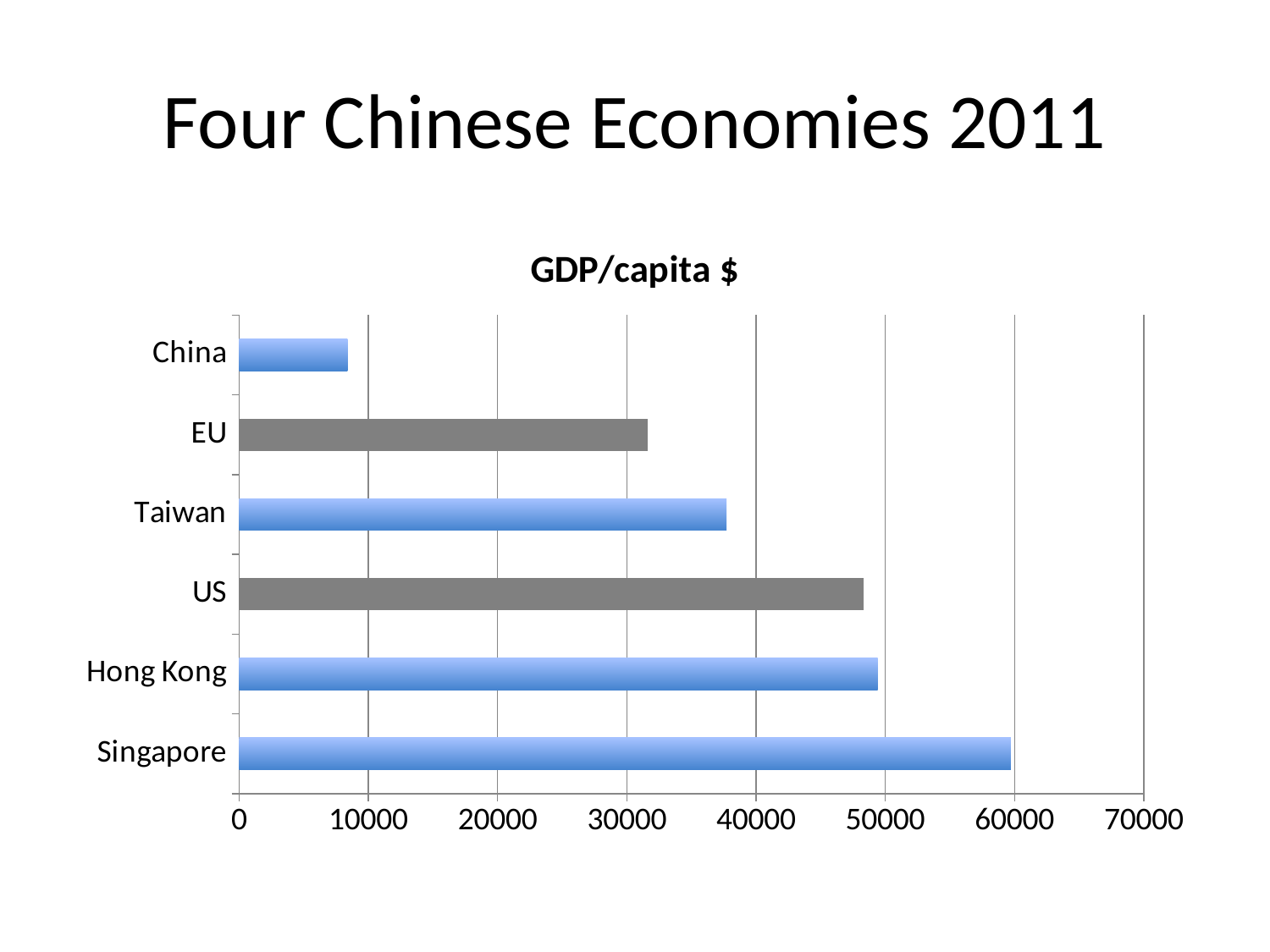
Which has a larger GDP/capita, Taiwan or EU? Taiwan What kind of chart is shown on the slide? bar chart Is the value for EU greater or less than 30000? greater What is the title of the chart? GDP/capita $ Is the value for Taiwan greater or less than 40000? less How many economies are plotted in the chart? 6 Is the value for China greater or less than 10000? less Which economy has the lowest GDP/capita in the chart? China Which economy has the highest GDP/capita in the chart? Singapore Which has a larger GDP/capita, Singapore or US? Singapore